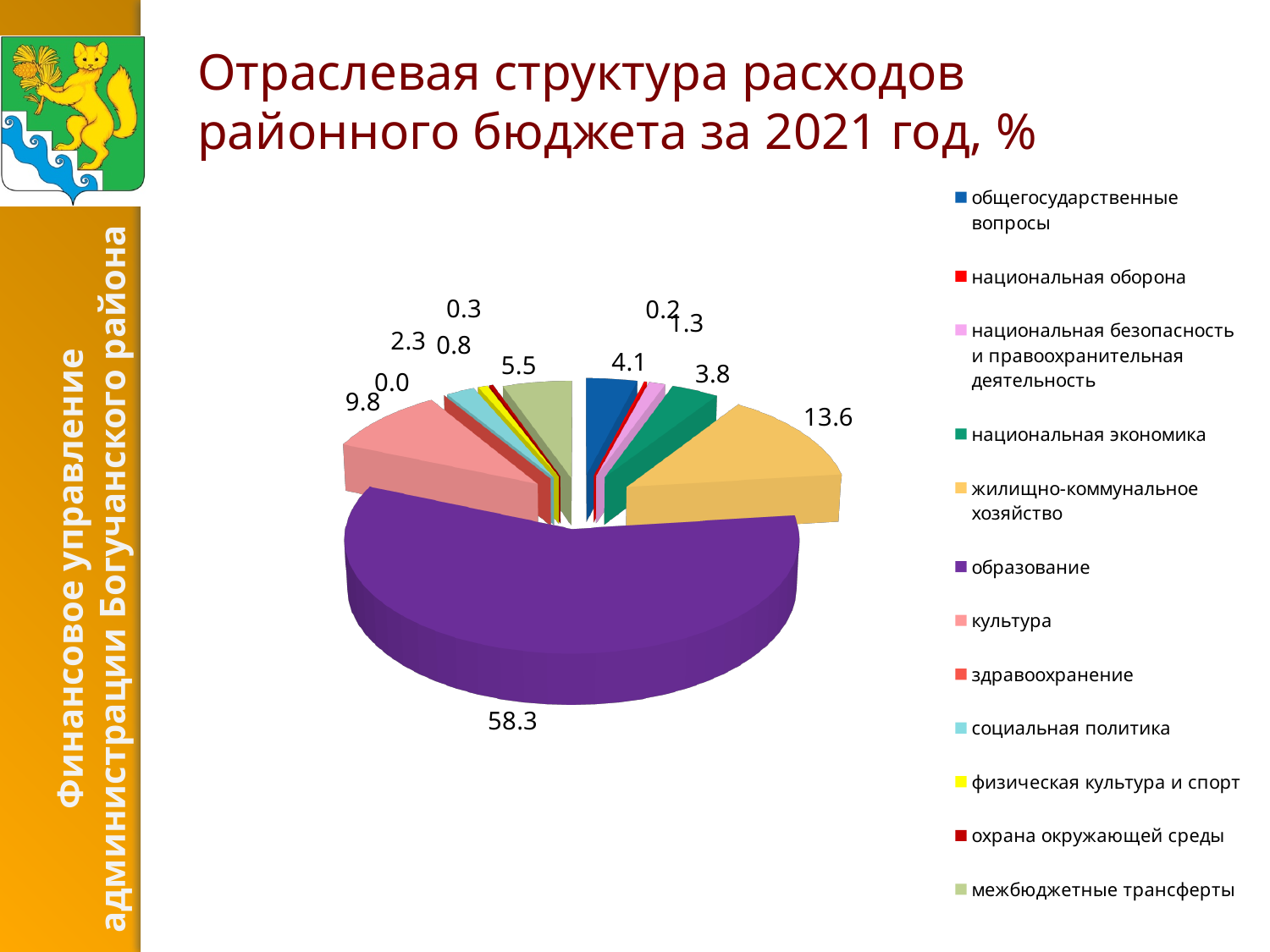
What is the difference between the values for образование and жилищно-коммунальное хозяйство? 44.7 What is the value for общегосударственные вопросы? 4.1 Which is larger, национальная экономика or общегосударственные вопросы? общегосударственные вопросы What is the value for образование? 58.3 What is the value for культура? 9.8 Which category has the smallest value? здравоохранение What is the value for межбюджетные трансферты? 5.5 What type of chart is shown on the slide? pie chart What is the value for жилищно-коммунальное хозяйство? 13.6 What is the title of the chart? Отраслевая структура расходов районного бюджета за 2021 год, % Which category has the largest share of the pie? образование How many categories does the legend list? 12